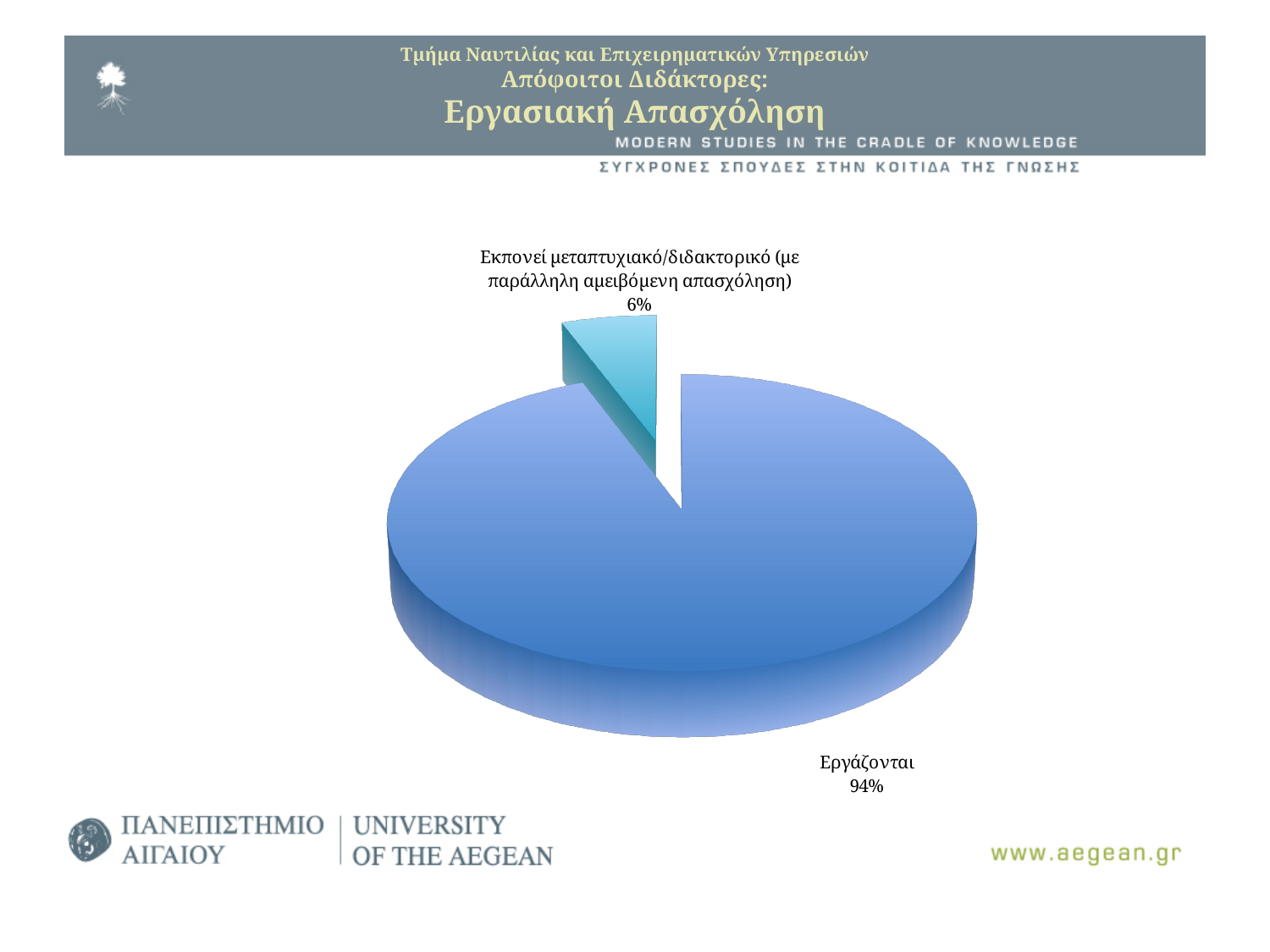
What colour is the "Εργάζονται" slice? blue Which category has the smallest slice of the pie? Εκπονεί μεταπτυχιακό/διδακτορικό (με παράλληλη αμειβόμενη απασχόληση) What share of the pie does the "Εργάζονται" slice represent? 94% What is the difference in percentage points between the "Εργάζονται" slice and the "Εκπονεί μεταπτυχιακό/διδακτορικό" slice? 88 percentage points Which slice is larger: "Εργάζονται" or "Εκπονεί μεταπτυχιακό/διδακτορικό (με παράλληλη αμειβόμενη απασχόληση)"? Εργάζονται How many slices does the pie chart have? 2 What is the main title of the slide above the chart? Εργασιακή Απασχόληση What kind of chart is shown on the slide? pie chart What is the total of the two percentages shown on the pie chart? 100% What share of the pie does the "Εκπονεί μεταπτυχιακό/διδακτορικό (με παράλληλη αμειβόμενη απασχόληση)" slice represent? 6% Which category has the largest slice of the pie? Εργάζονται